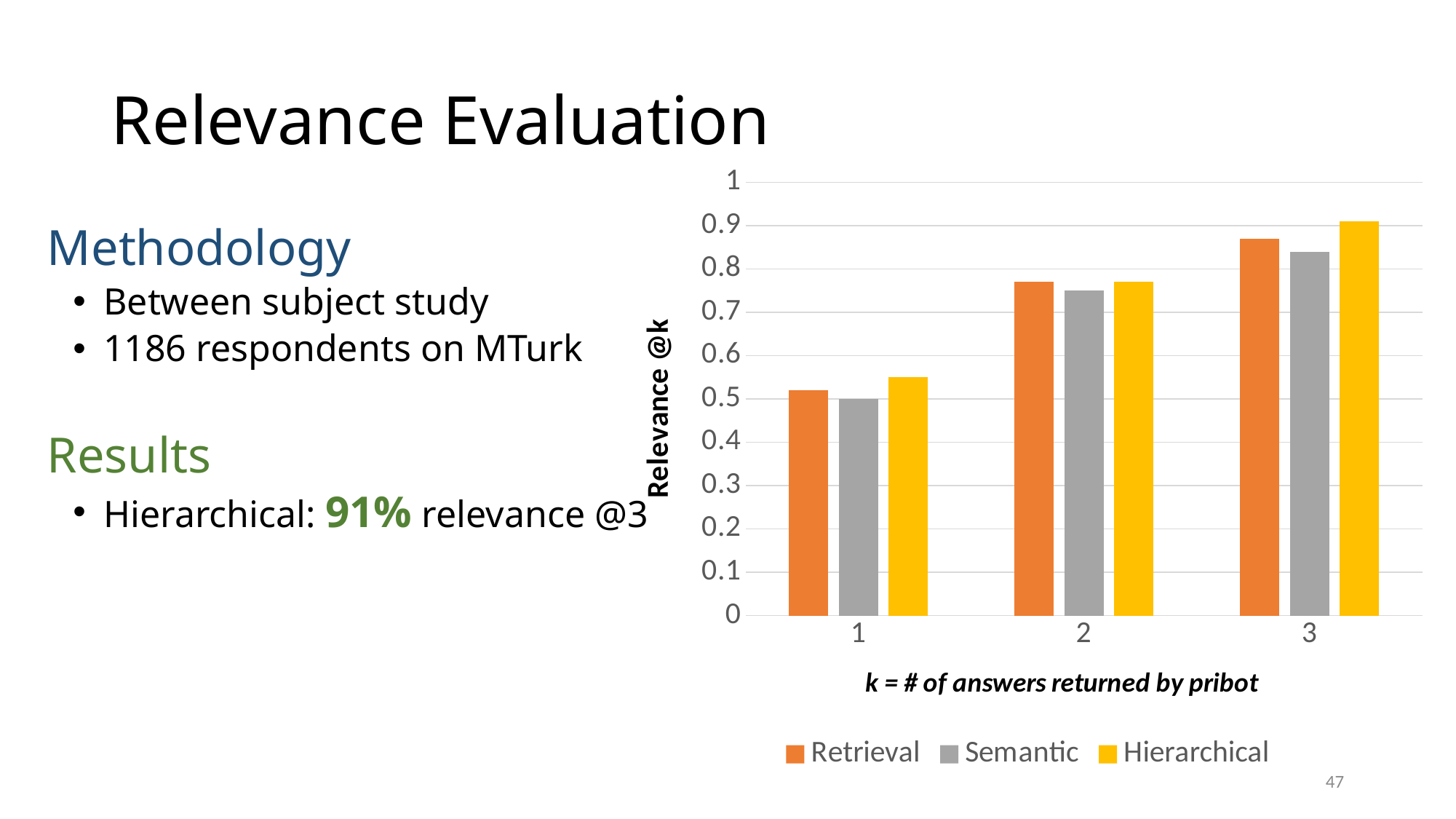
What is the title of the y axis? Relevance @k Which series has the highest relevance at k = 3? Hierarchical Is the Hierarchical value at k = 1 greater or less than 0.6? less Is the Hierarchical value at k = 3 greater or less than 0.8? greater How many series does the legend list? 3 How many values of k are shown on the x axis? 3 At k = 3, which is larger, the Semantic value or the Hierarchical value? Hierarchical What kind of chart is shown on the slide? bar chart Does the Retrieval relevance rise or fall as k increases from 1 to 3? rise Which series has the lowest relevance at k = 1? Semantic Which colour represents the Hierarchical series in the legend? yellow Is the Retrieval value at k = 2 greater or less than 0.8? less